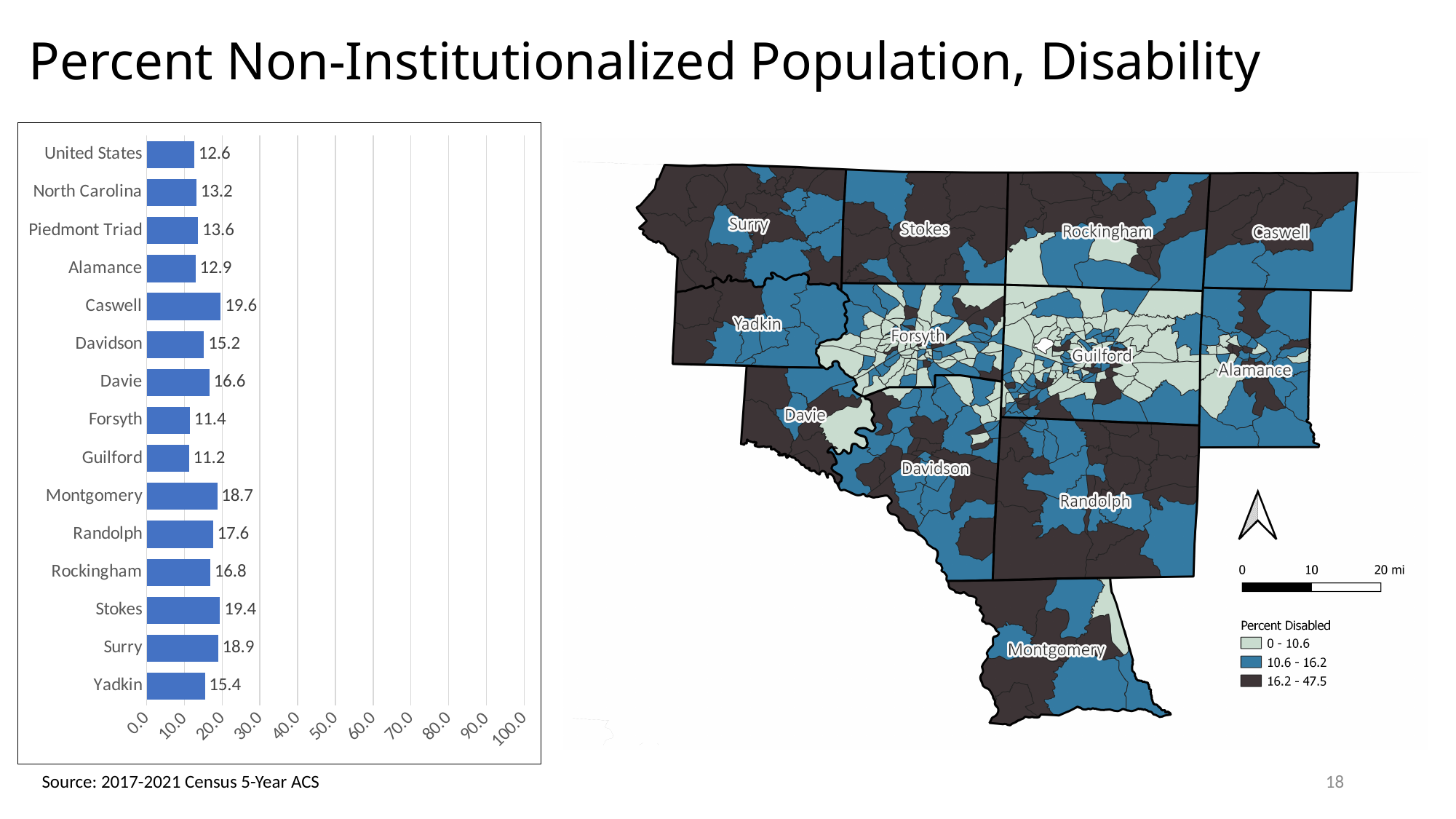
In the bar chart, is the value for Montgomery greater or less than 10.0? greater In the bar chart, which category has the highest value? Caswell In the bar chart, what is the value for the United States? 12.6 In the bar chart, what is the difference between the values for Davie and Davidson? 1.4 In the bar chart, which has a larger value, Surry or Randolph? Surry In the bar chart, what is the value for Caswell? 19.6 In the bar chart, what is the value for Piedmont Triad? 13.6 In the map legend, what range does the darkest colour class for Percent Disabled represent? 16.2 - 47.5 How many bars are shown in the bar chart? 15 In the bar chart, which category has the lowest value? Guilford What kind of chart is shown on the left of the slide? bar chart In the bar chart, what is the difference between the values for Caswell and Guilford? 8.4